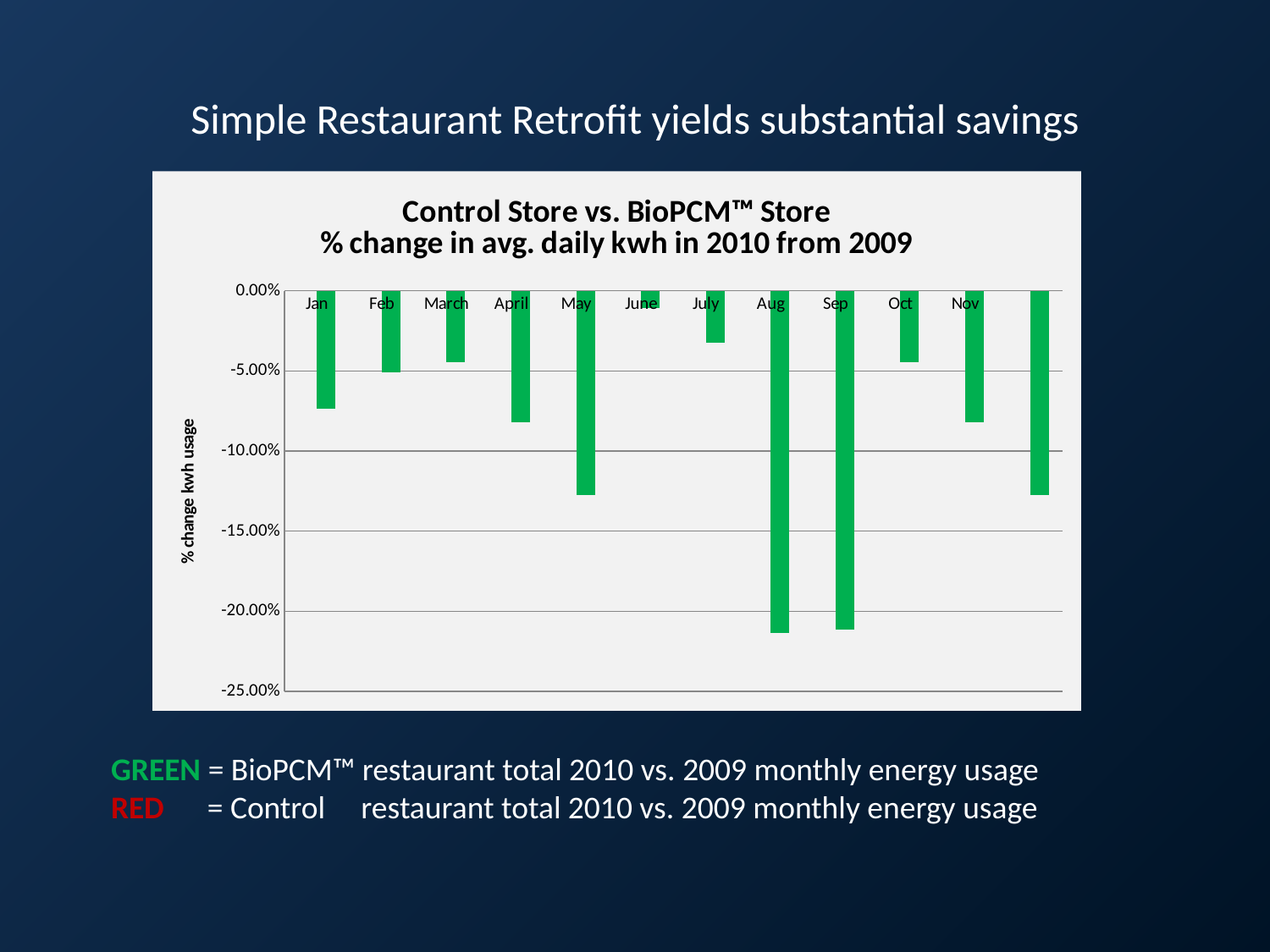
Is the value for Aug greater or less than -20.00%? less Is the value for June greater or less than -5.00%? greater What kind of chart is shown on the slide? bar chart Is the value for July greater or less than -5.00%? greater What is the label on the vertical axis of the chart? % change kwh usage How many bars are plotted in the chart? 12 Which month has the value closest to 0.00% (the smallest decrease)? June What is the title of the chart? Control Store vs. BioPCM™ Store % change in avg. daily kwh in 2010 from 2009 Which month shows a larger percentage decrease, May or July? May